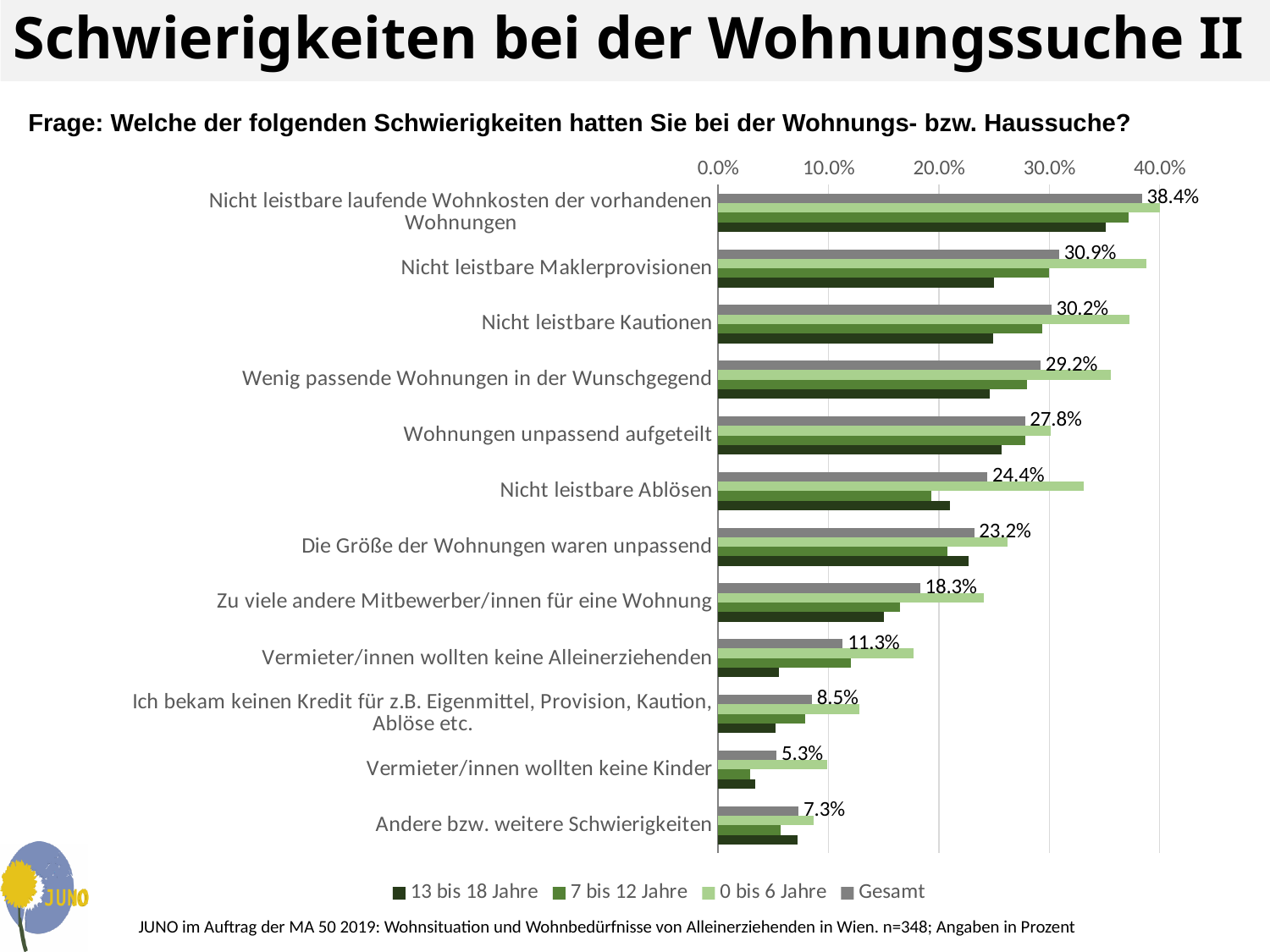
How many categories are shown in the chart? 12 How many series does the legend list? 4 Which category has the highest Gesamt value? Nicht leistbare laufende Wohnkosten der vorhandenen Wohnungen What is the Gesamt value for "Nicht leistbare laufende Wohnkosten der vorhandenen Wohnungen"? 38.4% What kind of chart is shown on the slide? Bar chart Which category has the lowest Gesamt value? Vermieter/innen wollten keine Kinder What is the Gesamt value for "Nicht leistbare Maklerprovisionen"? 30.9% Which series is shown in gray in the legend? Gesamt What is the Gesamt value for "Vermieter/innen wollten keine Kinder"? 5.3% What is the difference between the Gesamt values for "Nicht leistbare Kautionen" and "Nicht leistbare Ablösen"? 5.8% Which has a larger Gesamt value: "Zu viele andere Mitbewerber/innen für eine Wohnung" or "Vermieter/innen wollten keine Alleinerziehenden"? Zu viele andere Mitbewerber/innen für eine Wohnung Is the 0 bis 6 Jahre value for "Nicht leistbare Maklerprovisionen" greater or less than 30.0%? greater